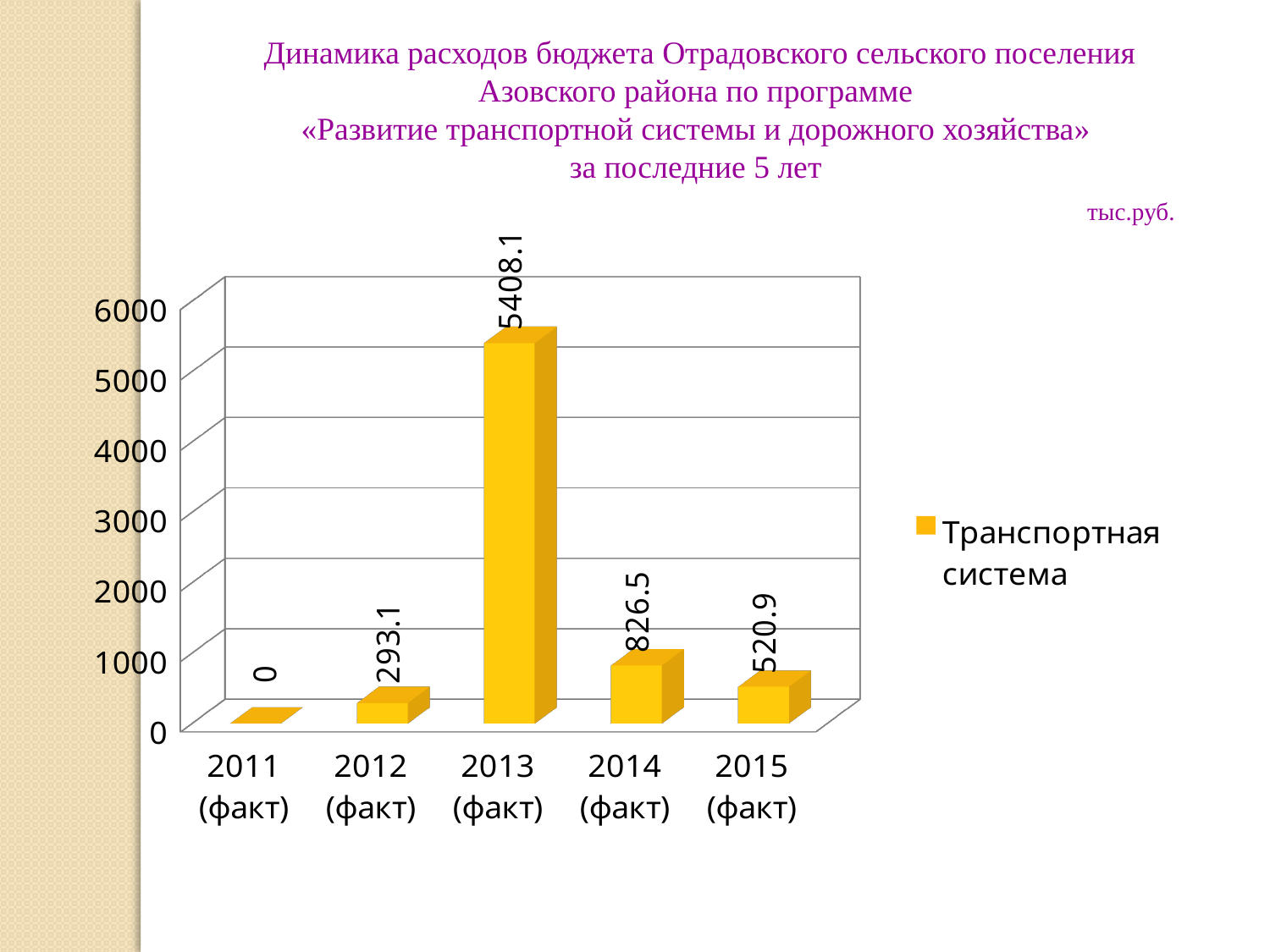
Which is larger, the value for 2012 (факт) or 2015 (факт)? 2015 (факт) What is the difference between the values for 2014 (факт) and 2015 (факт)? 305.6 What is the value for 2011 (факт)? 0 What kind of chart is this? bar chart How many years are shown on the x axis? 5 Which year has the highest value? 2013 (факт) Is the value for 2013 (факт) greater or less than 5000? greater Which year has the lowest value? 2011 (факт) What is the value for 2013 (факт)? 5408.1 What series does the legend list? Транспортная система What is the value for 2012 (факт)? 293.1 What is the value for 2014 (факт)? 826.5